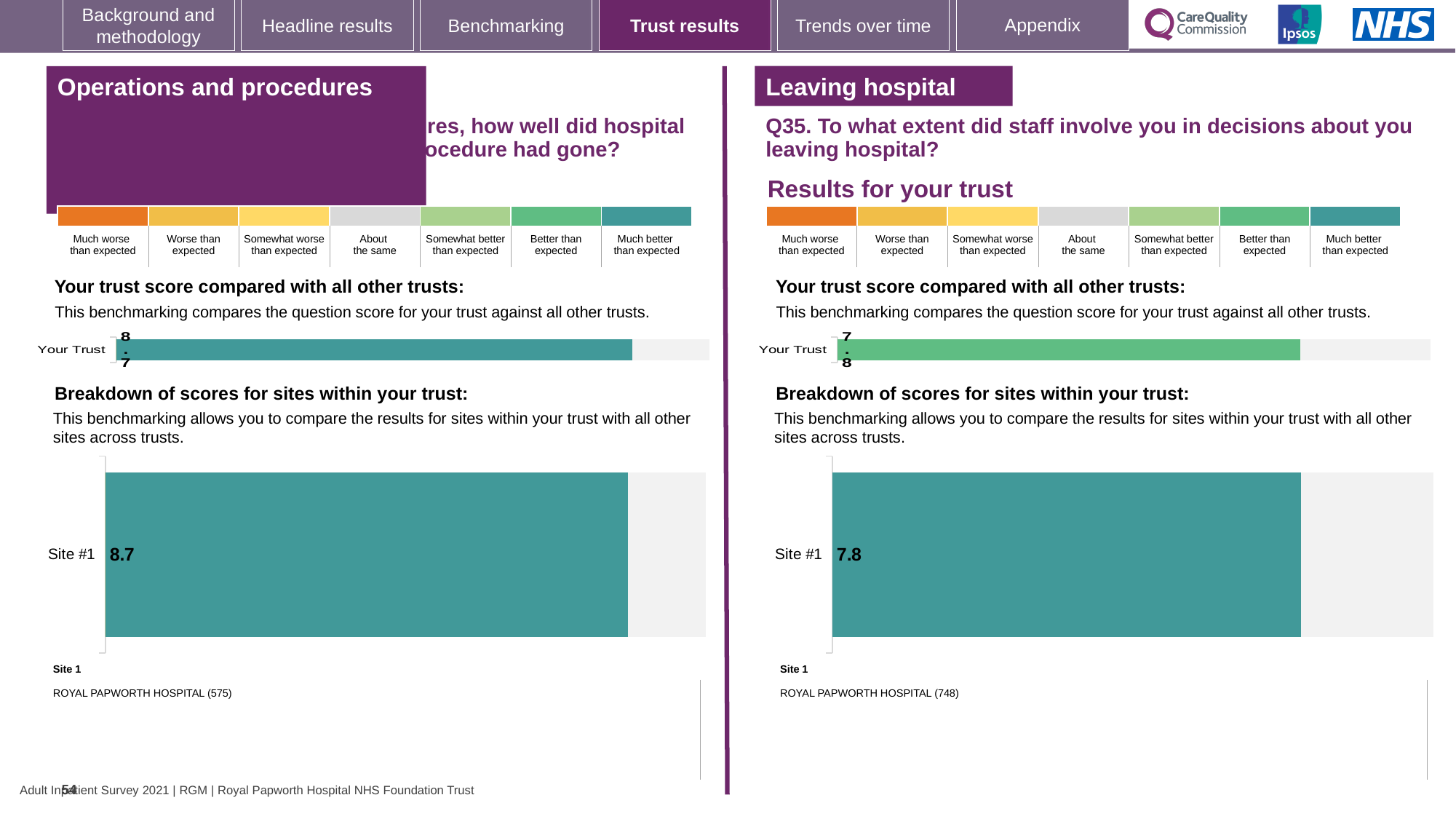
What colour is the Your Trust bar in the right-hand 'Leaving hospital' section? Green In the right-hand site breakdown chart for Q35, what is the score for Site #1? 7.8 How many sites are shown in the right-hand site breakdown chart? 1 On the right-hand 'Leaving hospital' section, what is the score shown for Your Trust? 7.8 Which hospital is listed as Site 1 in the right-hand section? ROYAL PAPWORTH HOSPITAL (748) What is the difference between the Site #1 score in the left-hand chart (8.7) and the Site #1 score in the right-hand chart (7.8)? 0.9 Which is larger: the Site #1 score in the left-hand chart or the Site #1 score in the right-hand chart? Left-hand chart (8.7) Is the Your Trust score in the left-hand section greater or less than the Your Trust score in the right-hand section? greater On the left-hand 'Operations and procedures' section, what is the score shown for Your Trust? 8.7 How many sites are shown in the left-hand site breakdown chart? 1 What type of chart is used to show the Site #1 score in the right-hand section? Bar chart In the left-hand site breakdown chart, what is the score for Site #1? 8.7